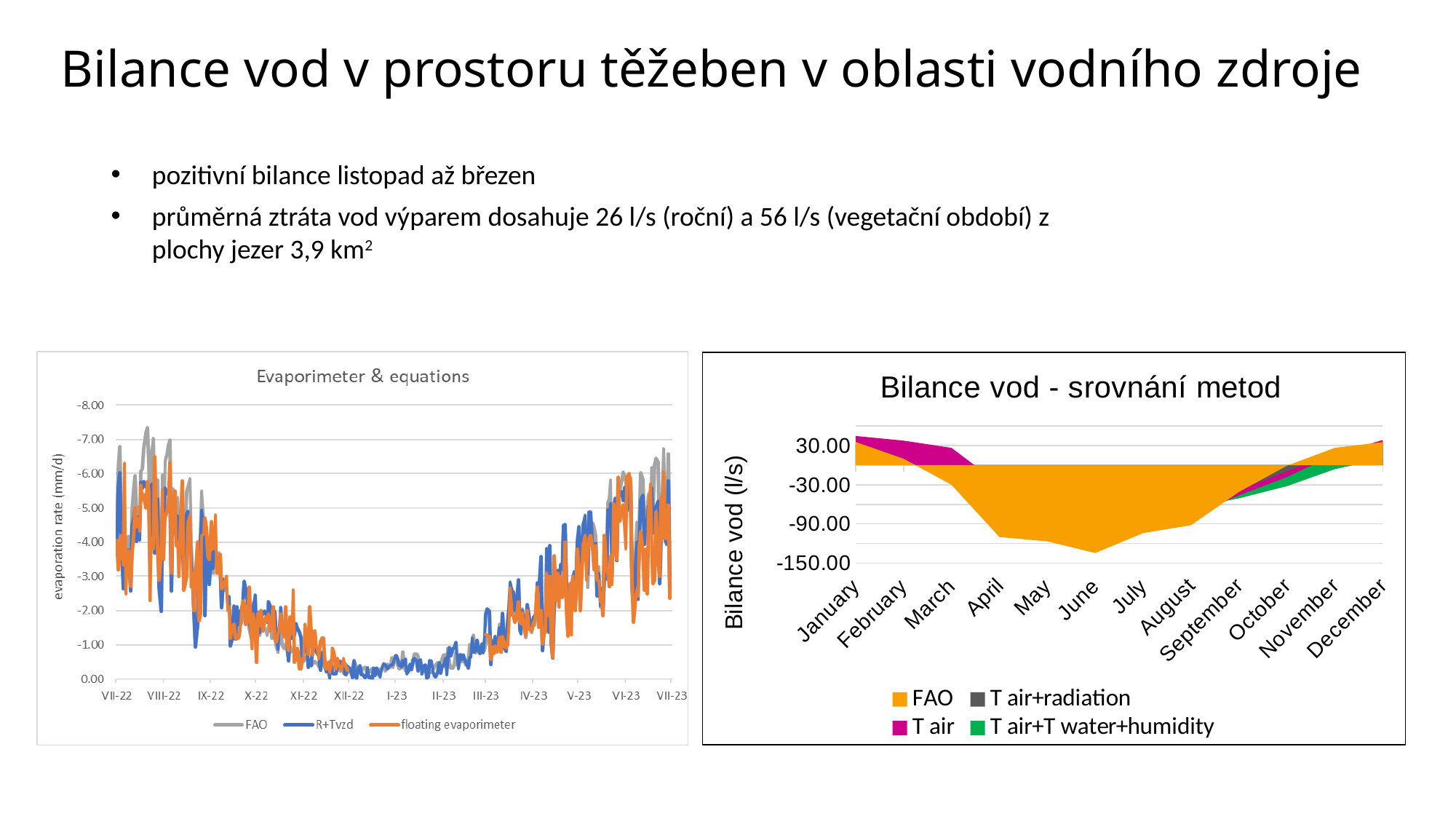
In the chart on the right (Bilance vod - srovnání metod), is the FAO value for December greater or less than 0? greater What kind of chart is the chart on the right (Bilance vod - srovnání metod)? area chart What is the title of the chart on the right? Bilance vod - srovnání metod In the chart on the left (Evaporimeter & equations), what is the y-axis label? evaporation rate (mm/d) In the chart on the left (Evaporimeter & equations), how many series does the legend list? 3 In the chart on the right (Bilance vod - srovnání metod), in which month does the FAO series reach its lowest value? June In the chart on the right (Bilance vod - srovnání metod), which colour represents the FAO series? orange In the chart on the right (Bilance vod - srovnání metod), how many series does the legend list? 4 In the chart on the right (Bilance vod - srovnání metod), how many months are shown on the x axis? 12 What kind of chart is the chart on the left (Evaporimeter & equations)? line chart In the chart on the right (Bilance vod - srovnání metod), is the FAO value for April greater or less than -30.00? less In the chart on the right (Bilance vod - srovnání metod), is the FAO value for June greater or less than -90.00? less